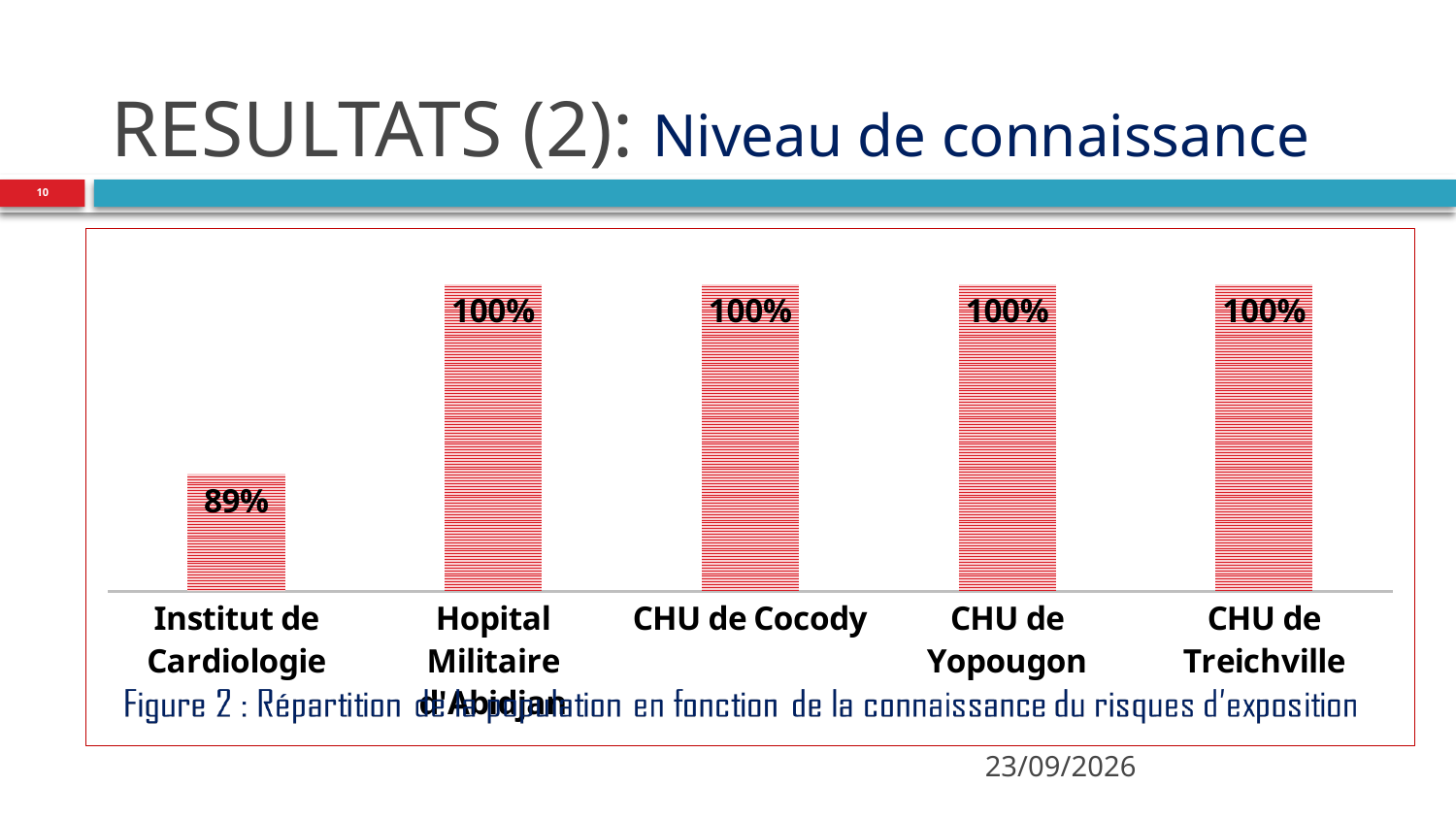
Which category has the lowest value? Institut de Cardiologie What is the difference between the value for CHU de Cocody and the value for Institut de Cardiologie? 11% What is the value for Institut de Cardiologie? 89% What is the value for CHU de Treichville? 100% How many categories are shown in the chart? 5 What is the value for Hopital Militaire d'Abidjan? 100% What is the value for CHU de Yopougon? 100% What kind of chart is shown on the slide? Bar chart Which is larger, the value for Institut de Cardiologie or the value for CHU de Yopougon? CHU de Yopougon What is the value for CHU de Cocody? 100% How many categories have a value of 100%? 4 What is the figure number given in the caption below the chart? Figure 2